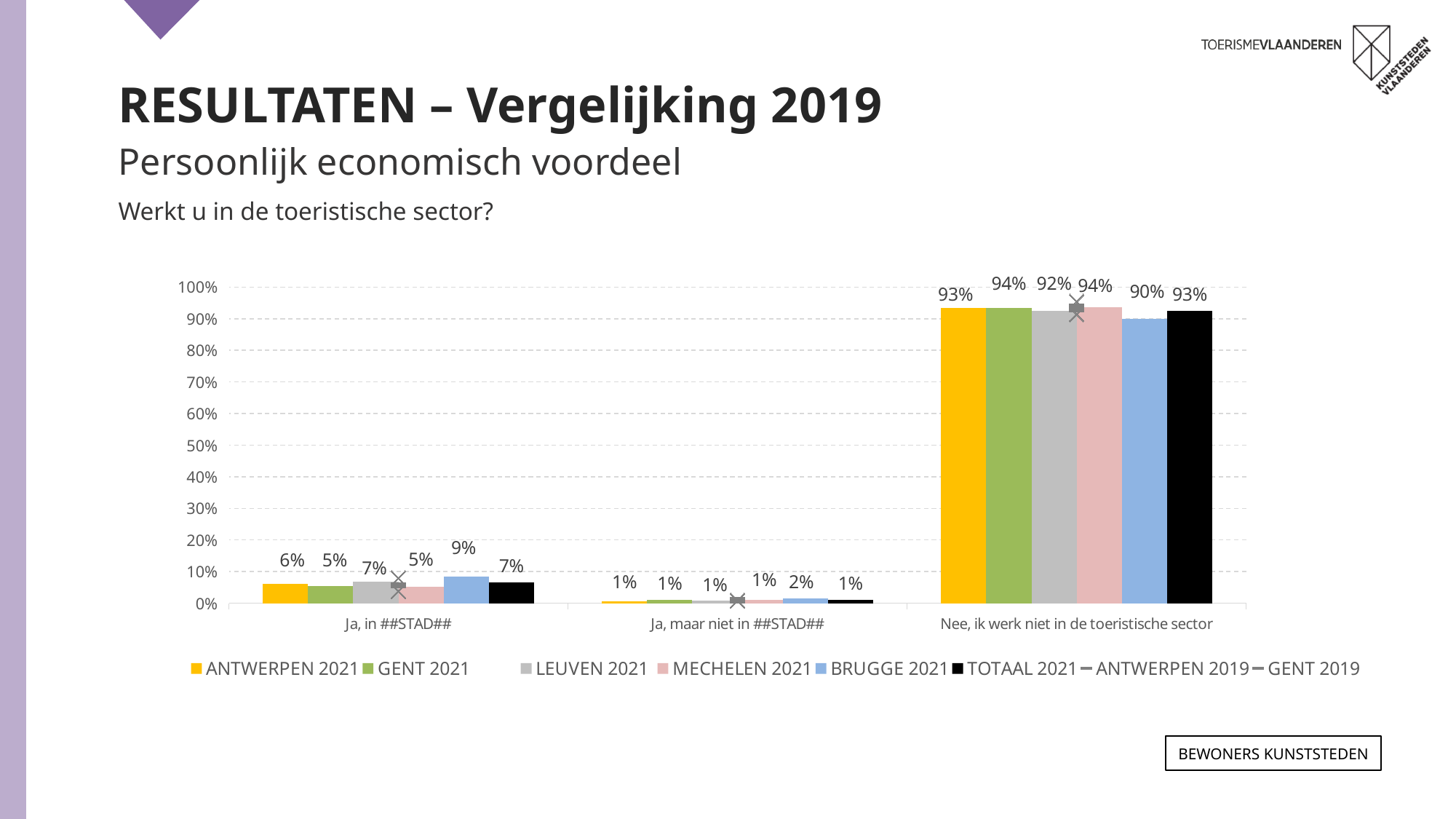
What is the difference between the BRUGGE 2021 and GENT 2021 values in the category "Ja, in ##STAD##"? 4% Which 2021 series has the highest value in the category "Ja, in ##STAD##"? BRUGGE 2021 What kind of chart is shown on the slide? Bar chart What is the value for LEUVEN 2021 in the category "Nee, ik werk niet in de toeristische sector"? 92% How many categories are shown on the x axis of the chart? 3 Which 2021 series has the lowest value in the category "Nee, ik werk niet in de toeristische sector"? BRUGGE 2021 What is the value for BRUGGE 2021 in the category "Ja, maar niet in ##STAD##"? 2% In the category "Nee, ik werk niet in de toeristische sector", which is larger: GENT 2021 or BRUGGE 2021? GENT 2021 What is the value for BRUGGE 2021 in the category "Ja, in ##STAD##"? 9% What is the value for TOTAAL 2021 in the category "Nee, ik werk niet in de toeristische sector"? 93% Is the value for ANTWERPEN 2021 in the category "Nee, ik werk niet in de toeristische sector" greater or less than 80%? greater How many series does the chart legend list? 8